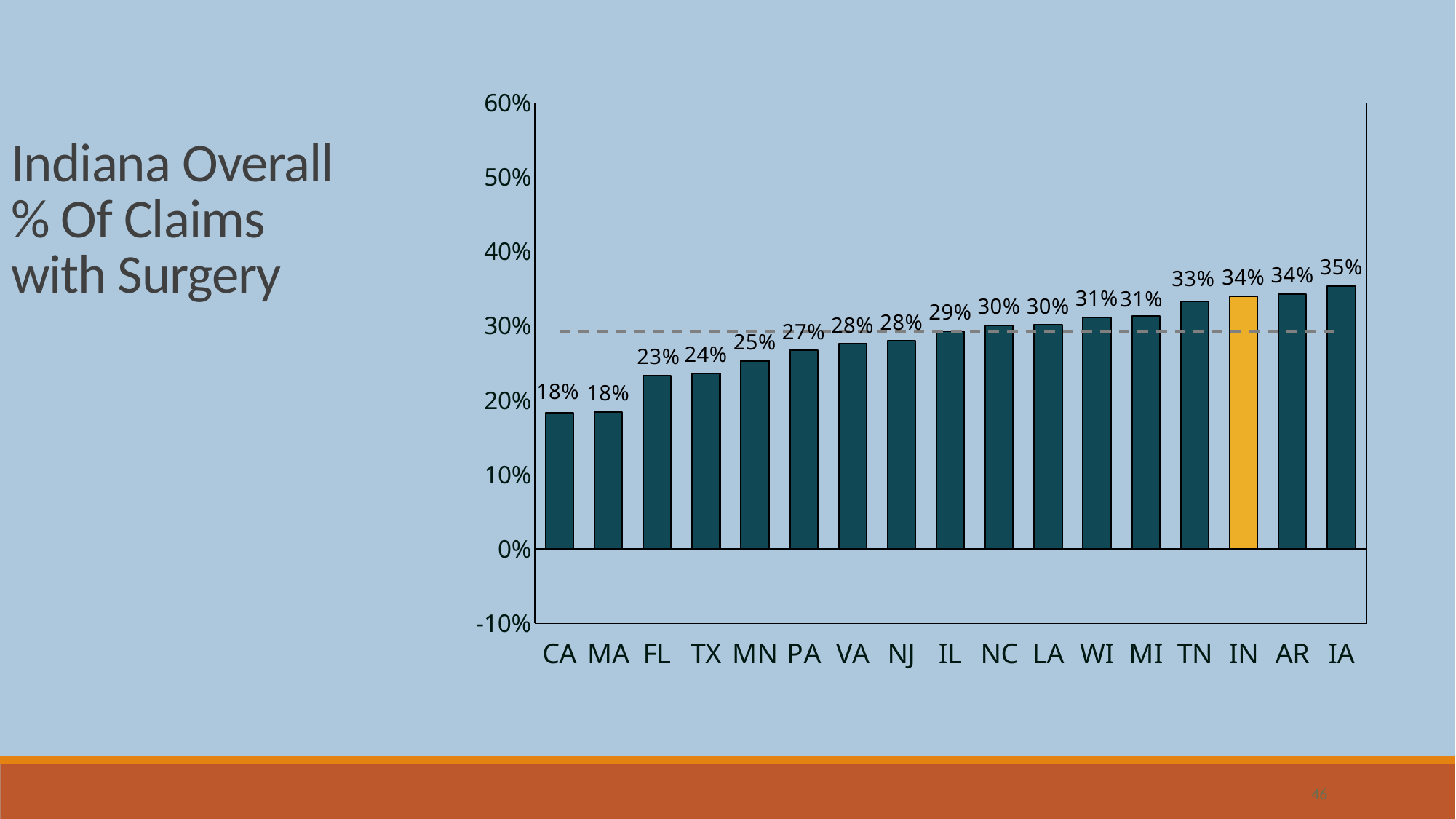
What is the value for FL? 23% What is the difference between the values for IN and MN? 9 percentage points What is the value for IN? 34% Is the value for IN greater or less than 30%? greater Which is larger, the value for IN or the value for FL? IN What kind of chart is shown on the slide? Bar chart How many states are shown on the x axis? 17 What is the value for TN? 33% Which state has the highest % of claims with surgery? IA Which state's bar is highlighted in a different colour (orange) from the others? IN Do the values rise or fall from left to right along the x axis? Rise What is the difference between the values for IA and CA? 17 percentage points